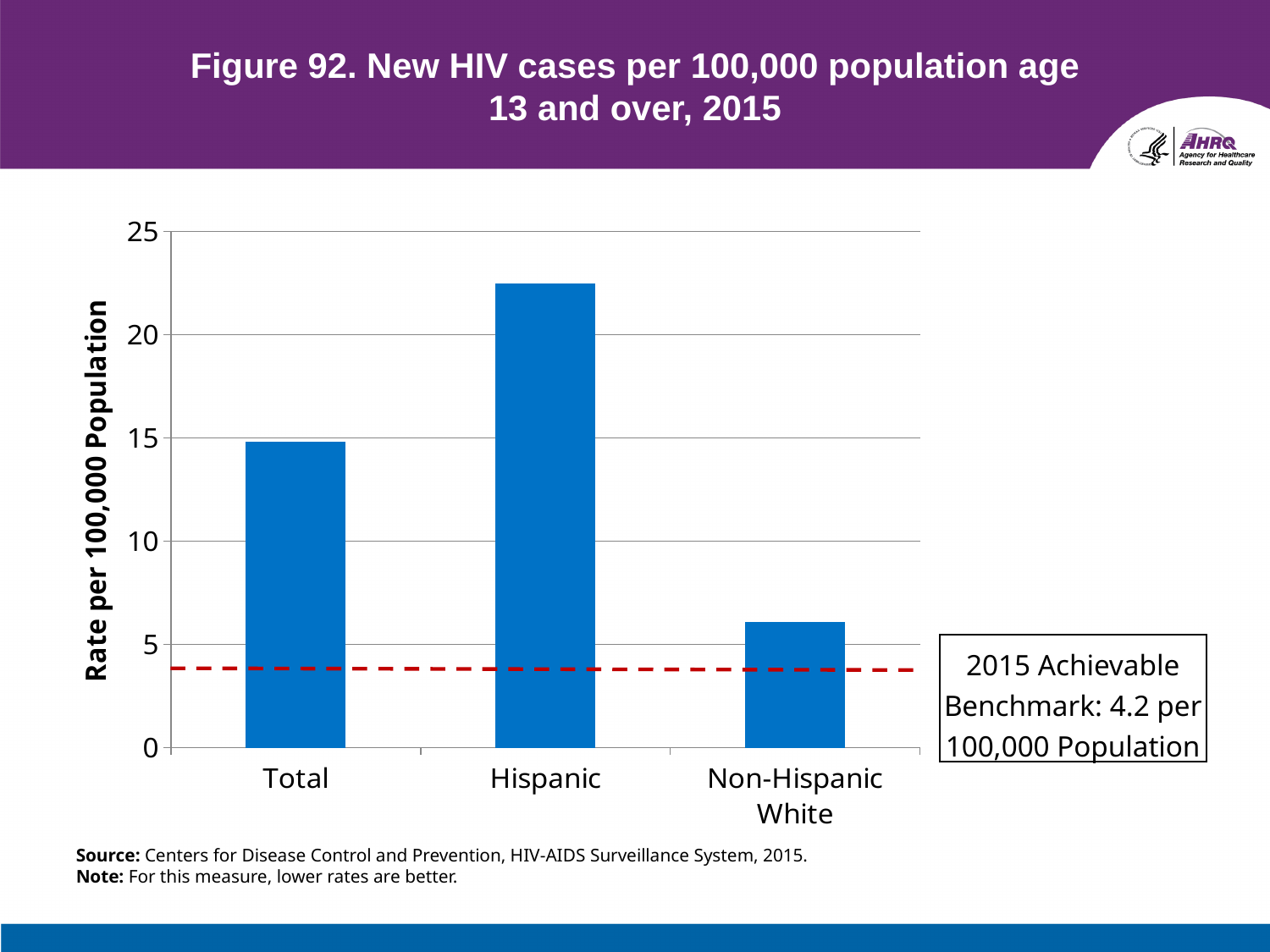
Is the value for Non-Hispanic White greater or less than 10? less What is the 2015 achievable benchmark shown by the dashed line? 4.2 per 100,000 Population Which category has the highest rate? Hispanic What kind of chart is shown on the slide? bar chart How many categories are shown on the x axis? 3 Is the value for Total greater or less than 10? greater Is the value for Non-Hispanic White greater or less than 5? greater What is the label of the y axis? Rate per 100,000 Population Which category has the lowest rate? Non-Hispanic White Which is larger, the value for Total or the value for Non-Hispanic White? Total